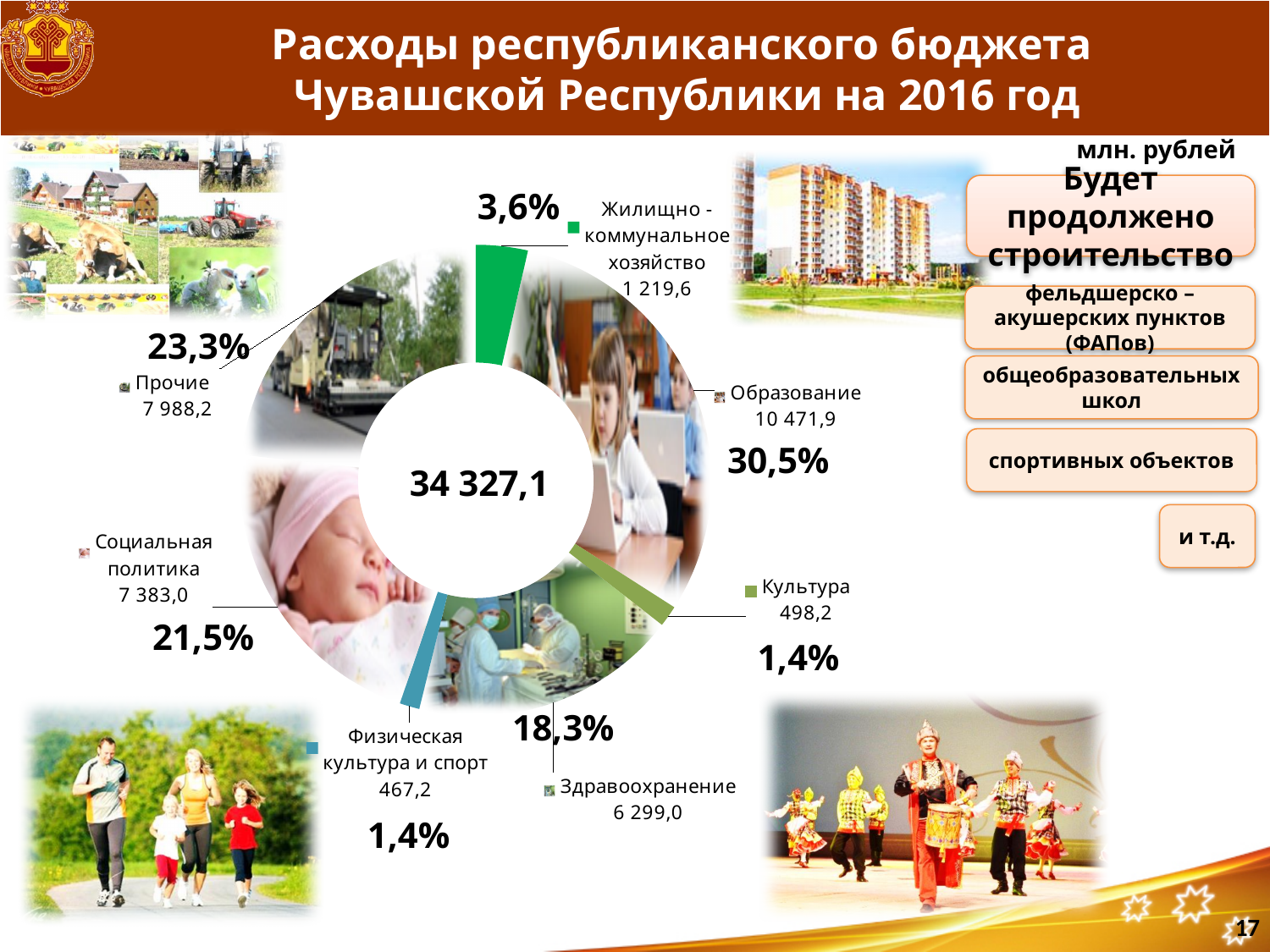
Which category has the highest value? Образование What is the value for Здравоохранение? 6 299,0 What share of the total does Социальная политика represent? 21,5% Which category has the lowest value? Физическая культура и спорт What share of the total does Образование represent? 30,5% Which is larger, the value for Прочие or the value for Социальная политика? Прочие What kind of chart is shown on the slide? Pie (doughnut) chart What total value is shown in the centre of the chart? 34 327,1 How many categories does the chart show? 7 What is the value for Образование? 10 471,9 What is the value for Жилищно-коммунальное хозяйство? 1 219,6 What is the difference between the values for Образование and Здравоохранение? 4 172,9